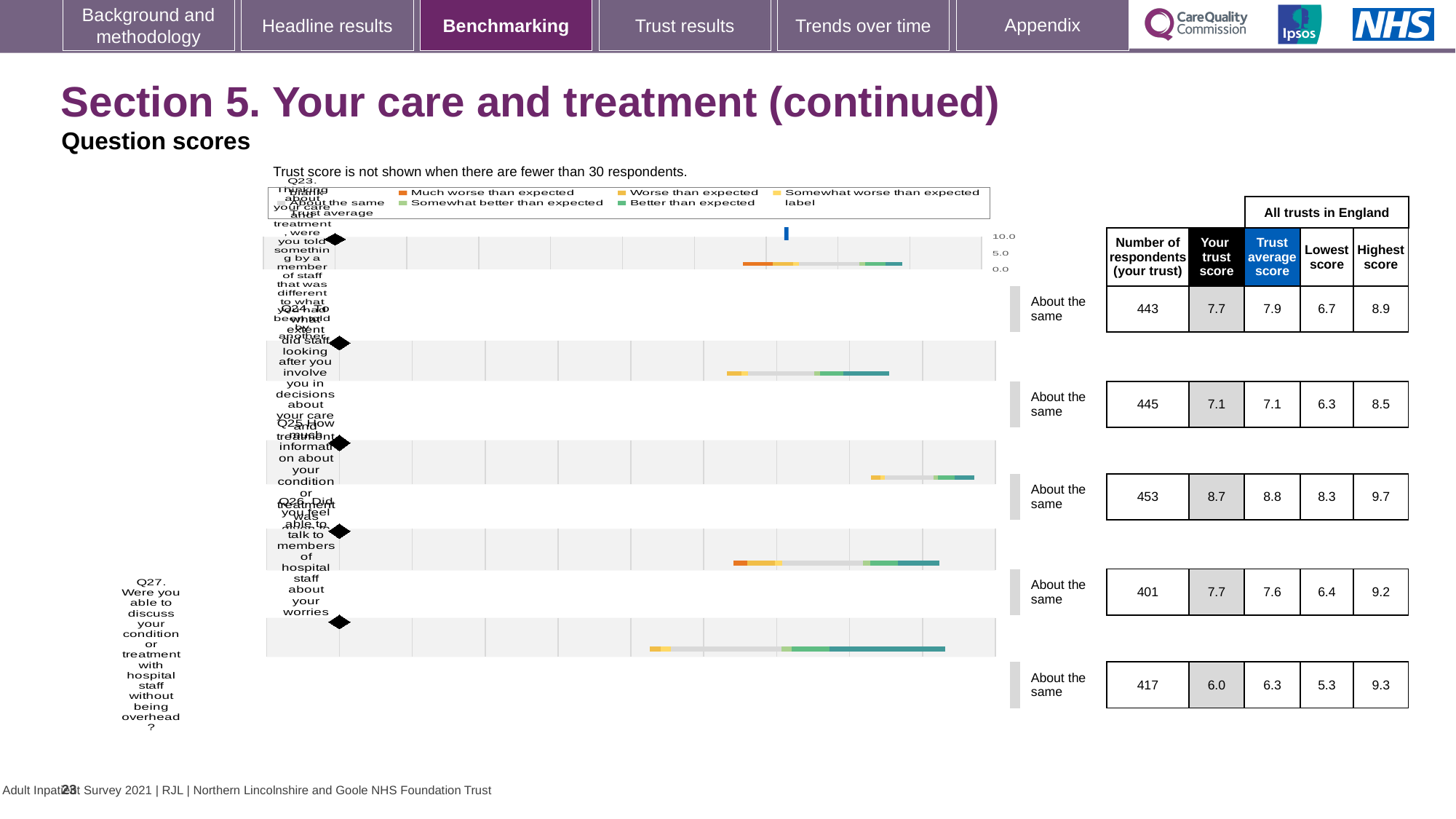
What is the trust average score for Q24 (did staff involve you in decisions about your care and treatment)? 7.1 What is the difference between the highest score (9.7) and the lowest score (8.3) for Q25? 1.4 Which question has the highest trust score for this trust? Q25 Which question has the lowest trust score for this trust? Q27 What is the trust score for Q27 (able to discuss your condition or treatment without being overheard)? 6.0 For Q23, which is larger: the trust score or the trust average score? Trust average score How many respondents answered Q26 (able to talk to members of hospital staff about your worries)? 401 What benchmark category is shown for every question on this slide? About the same What kind of chart is used to show the question scores on this slide? bar chart How many questions (Q23 to Q27) are plotted in the chart? 5 What is the lowest score across all trusts in England for Q27? 5.3 What is the trust score for Q25 (how much information about your condition or treatment was given)? 8.7